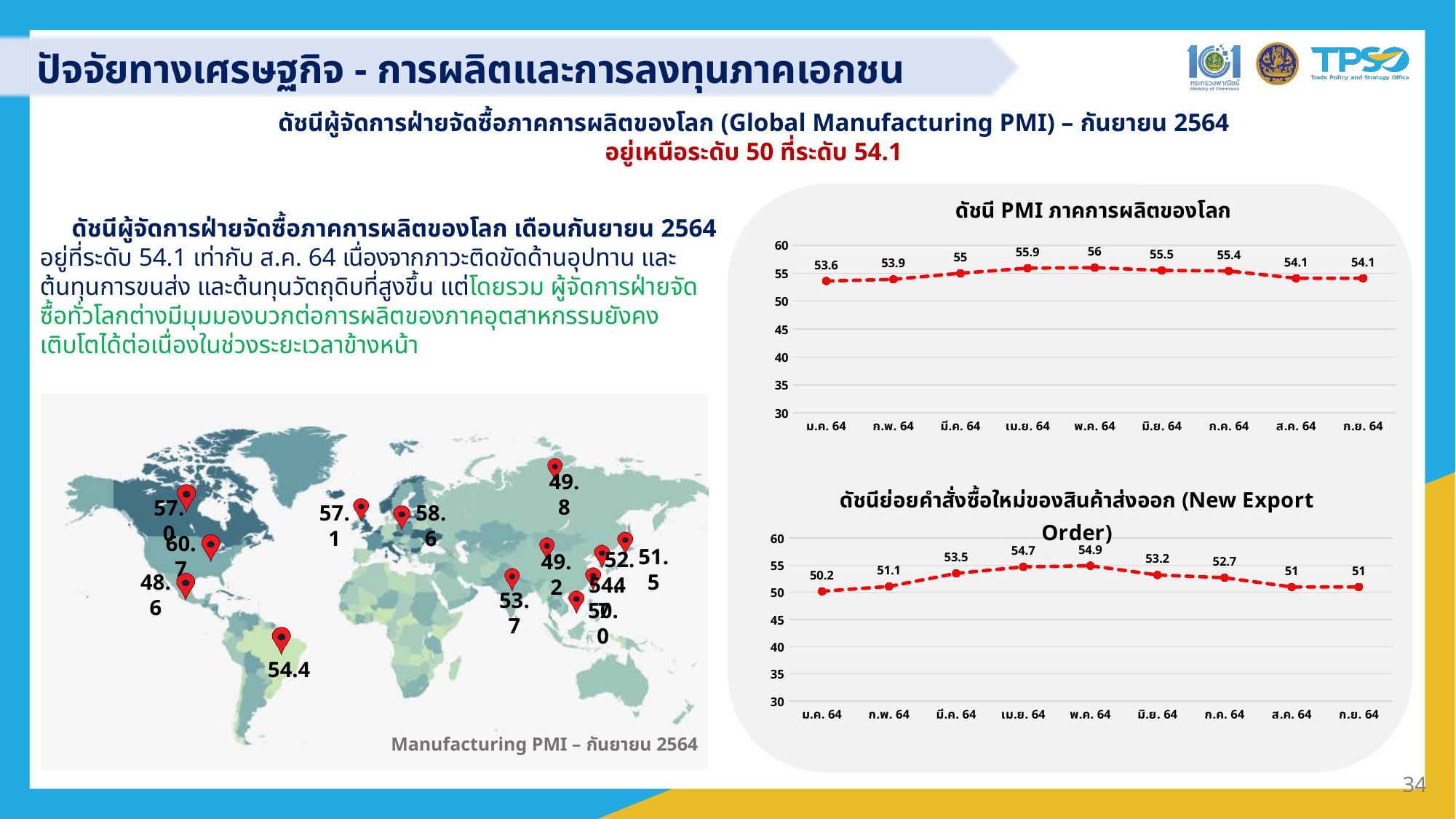
What type of chart is the bottom-right chart 'ดัชนีย่อยคำสั่งซื้อใหม่ของสินค้าส่งออก (New Export Order)'? Line chart In the bottom-right chart 'New Export Order', what is the value for เม.ย. 64? 54.7 In the top-right chart 'ดัชนี PMI ภาคการผลิตของโลก', which month has the lowest value? ม.ค. 64 In the top-right chart 'ดัชนี PMI ภาคการผลิตของโลก', what is the difference between the values for พ.ค. 64 and ก.ย. 64? 1.9 How many data points are plotted in the top-right chart 'ดัชนี PMI ภาคการผลิตของโลก'? 9 In the top-right chart 'ดัชนี PMI ภาคการผลิตของโลก', what is the value for ม.ค. 64? 53.6 In the bottom-right chart 'New Export Order', which month has the lowest value? ม.ค. 64 In the bottom-right chart 'New Export Order', which is larger, the value for มี.ค. 64 or the value for ก.ค. 64? มี.ค. 64 In the top-right chart 'ดัชนี PMI ภาคการผลิตของโลก', what is the value for พ.ค. 64? 56 In the bottom-right chart 'New Export Order', do the values rise or fall from พ.ค. 64 to ส.ค. 64? Fall In the bottom-right chart 'New Export Order', which month has the highest value? พ.ค. 64 In the top-right chart 'ดัชนี PMI ภาคการผลิตของโลก', which month has the highest value? พ.ค. 64